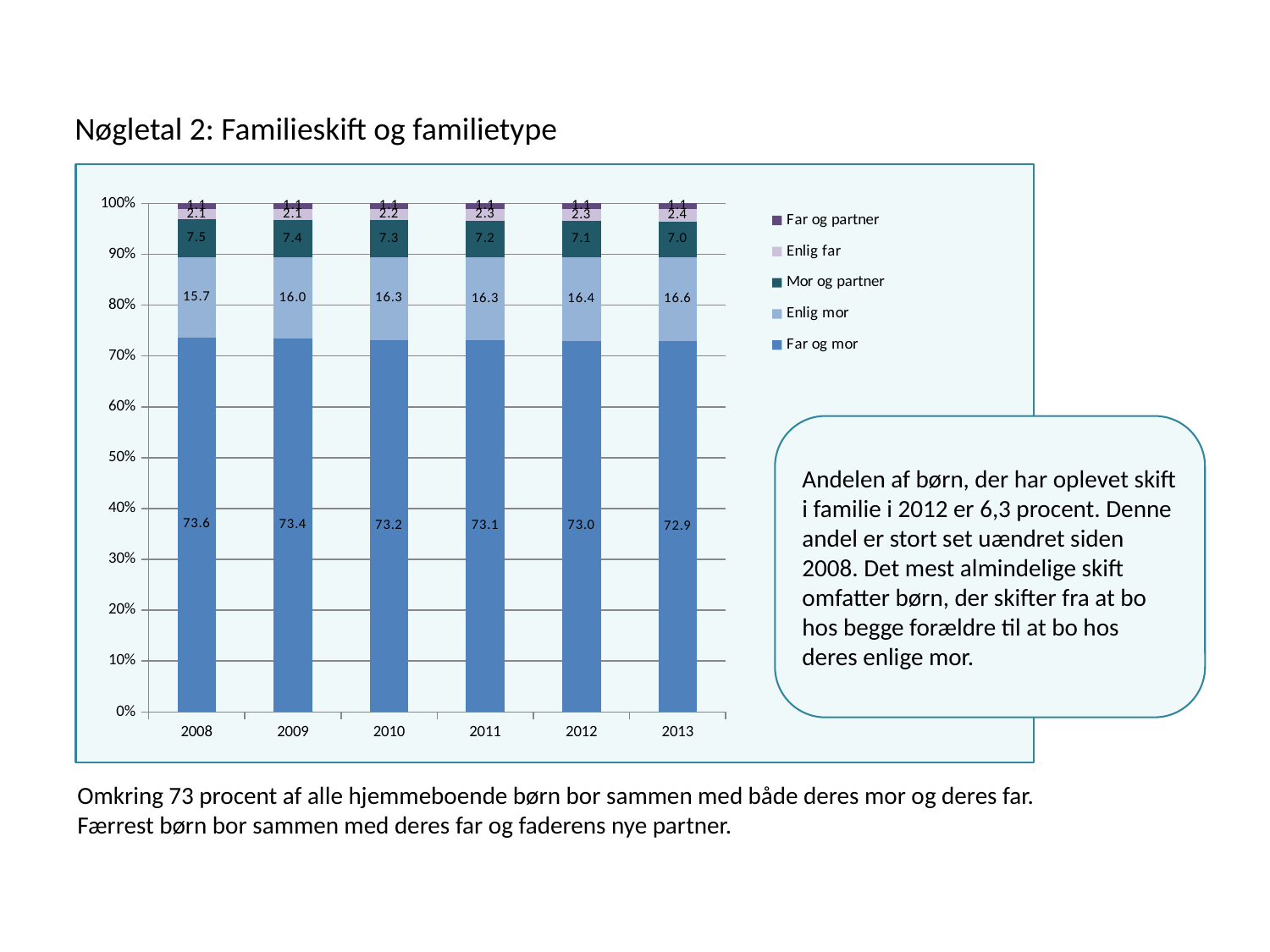
In which year is the value for Enlig mor lowest? 2008 What is the value for Enlig far in 2012? 2.3 In which year is the value for Far og mor highest? 2008 How many series does the legend list? 5 Does the value for Far og mor rise or fall from 2008 to 2013? Fall How many years are shown on the x axis? 6 What is the value for Far og mor in 2008? 73.6 What is the difference between the Far og mor values for 2008 and 2013? 0.7 What kind of chart is shown on the slide? Stacked bar chart What is the value for Mor og partner in 2011? 7.2 Which is larger, the Mor og partner value in 2008 or in 2013? 2008 What is the value for Enlig mor in 2013? 16.6